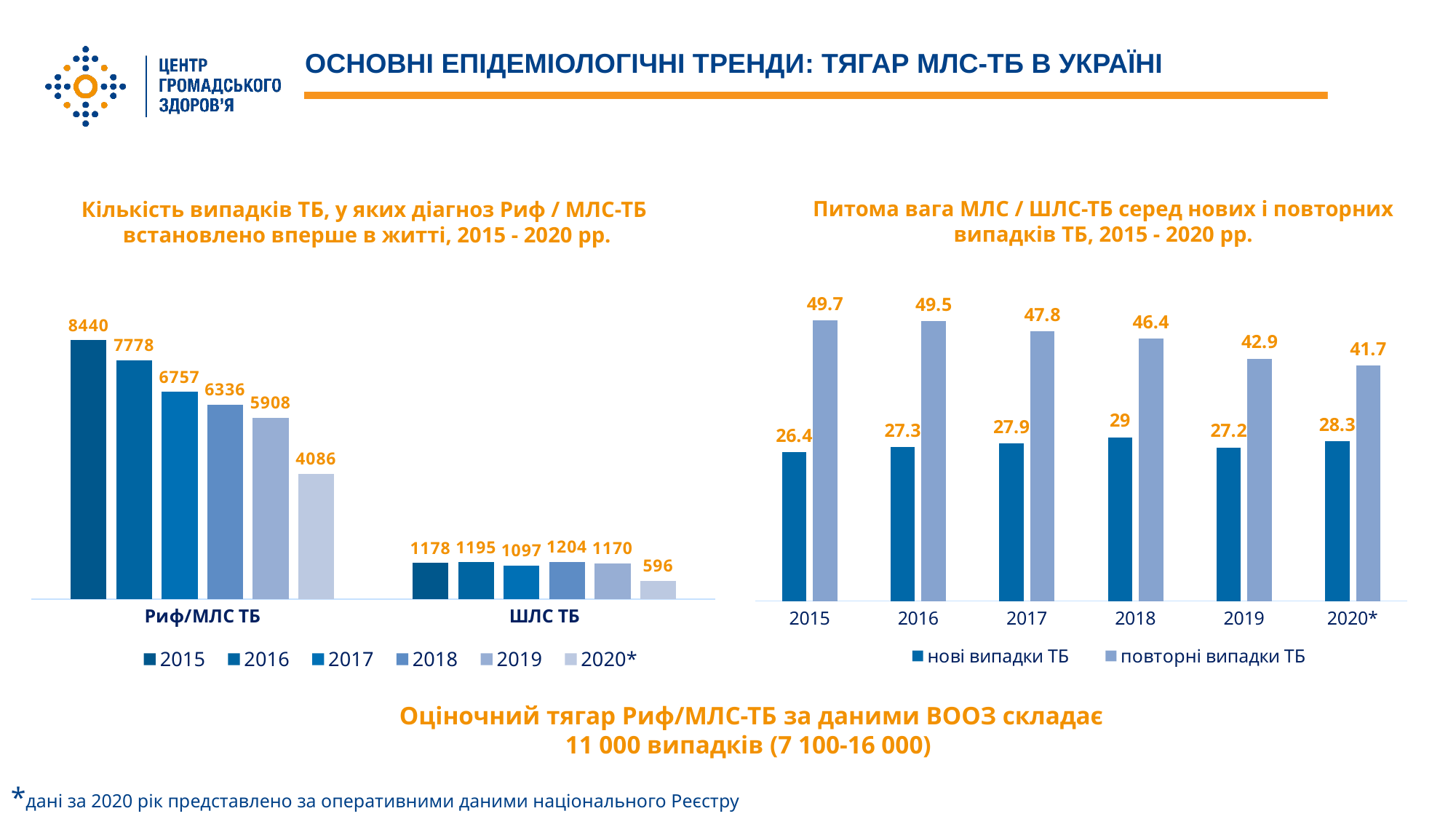
In the right chart (Питома вага МЛС / ШЛС-ТБ...), which year has the lowest value for повторні випадки ТБ? 2020* In the left chart (Кількість випадків ТБ...), what is the difference between the Риф/МЛС ТБ values for 2015 and 2020*? 4354 In the left chart (Кількість випадків ТБ...), which year has the highest value for ШЛС ТБ? 2018 In the right chart (Питома вага МЛС / ШЛС-ТБ...), how many years are shown on the x axis? 6 In the left chart (Кількість випадків ТБ...), what is the value for ШЛС ТБ in 2020*? 596 In the right chart (Питома вага МЛС / ШЛС-ТБ...), what is the difference between повторні випадки ТБ and нові випадки ТБ in 2015? 23.3 In the right chart (Питома вага МЛС / ШЛС-ТБ...), what is the value for повторні випадки ТБ in 2017? 47.8 In the left chart (Кількість випадків ТБ...), what is the value for Риф/МЛС ТБ in 2015? 8440 In the right chart (Питома вага МЛС / ШЛС-ТБ...), what is the value for нові випадки ТБ in 2018? 29 What type of chart is the right chart (Питома вага МЛС / ШЛС-ТБ...)? bar chart In the left chart (Кількість випадків ТБ...), do the Риф/МЛС ТБ values rise or fall from 2015 to 2020*? fall In the left chart (Кількість випадків ТБ...), how many series does the legend list? 6